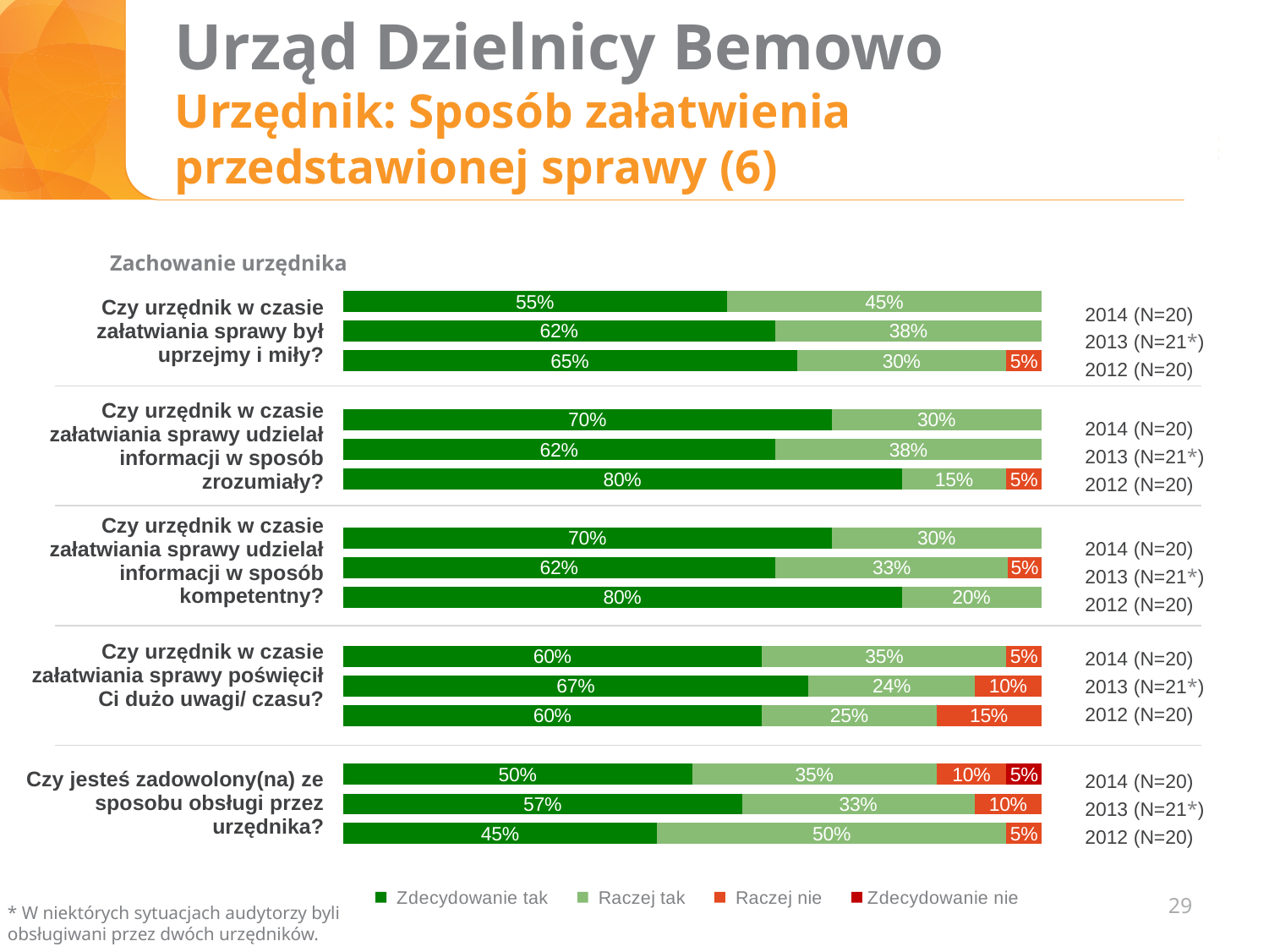
What kind of chart is used on the slide? Stacked bar chart In the chart for "Czy urzędnik w czasie załatwiania sprawy udzielał informacji w sposób zrozumiały?", which year has the highest "Zdecydowanie tak" value? 2012 (N=20) In the chart for "Czy urzędnik w czasie załatwiania sprawy był uprzejmy i miły?", what is the "Zdecydowanie tak" value for 2014 (N=20)? 55% In the chart for "Czy urzędnik w czasie załatwiania sprawy udzielał informacji w sposób kompetentny?", what is the difference between the "Zdecydowanie tak" values for 2012 (N=20) and 2014 (N=20)? 10% In the chart for "Czy urzędnik w czasie załatwiania sprawy poświęcił Ci dużo uwagi/ czasu?", which year has the lowest "Raczej tak" value? 2013 (N=21*) How many bars are shown in the chart for "Czy urzędnik w czasie załatwiania sprawy był uprzejmy i miły?"? 3 In the chart for "Czy urzędnik w czasie załatwiania sprawy poświęcił Ci dużo uwagi/ czasu?", what is the "Raczej nie" value for 2012 (N=20)? 15% In the chart for "Czy jesteś zadowolony(na) ze sposobu obsługi przez urzędnika?", what is the "Zdecydowanie tak" value for 2013 (N=21*)? 57% How many series does the legend list? 4 In the chart for "Czy jesteś zadowolony(na) ze sposobu obsługi przez urzędnika?", what is the combined share of "Raczej nie" and "Zdecydowanie nie" for 2014 (N=20)? 15% In the chart for "Czy jesteś zadowolony(na) ze sposobu obsługi przez urzędnika?", is the "Zdecydowanie tak" value larger for 2014 (N=20) or 2012 (N=20)? 2014 (N=20) In the chart for "Czy urzędnik w czasie załatwiania sprawy był uprzejmy i miły?", what is the "Raczej tak" value for 2012 (N=20)? 30%